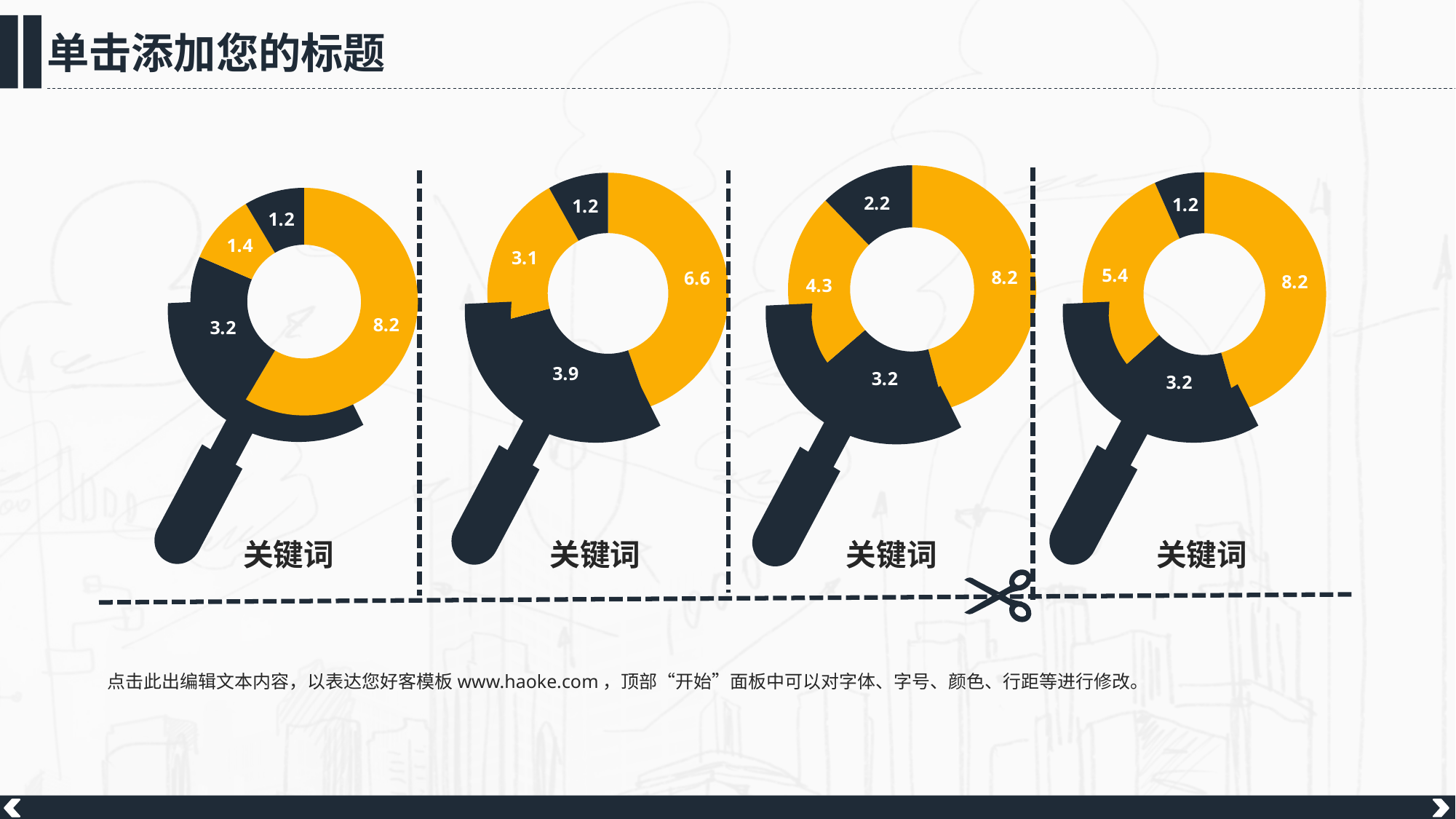
What two colours are used for the slices in the charts? Orange and dark navy In the leftmost chart, how many slices does the donut have? 4 In the leftmost chart, what is the value of the largest slice? 8.2 In the leftmost chart, what is the value of the smallest slice? 1.2 In the second chart from the left, what is the value of the largest slice? 6.6 What kind of chart is each of the four charts on the slide? Donut (pie) chart In the rightmost chart, what is the difference between the slice labelled 8.2 and the slice labelled 5.4? 2.8 How many charts are shown on the slide? 4 In the second chart from the left, what is the difference between the largest slice (6.6) and the smallest slice (1.2)? 5.4 In the third chart from the left, which is larger: the slice labelled 4.3 or the slice labelled 3.2? 4.3 In the third chart from the left, what is the value of the smallest slice? 2.2 In the rightmost chart, what is the value of the smallest slice? 1.2